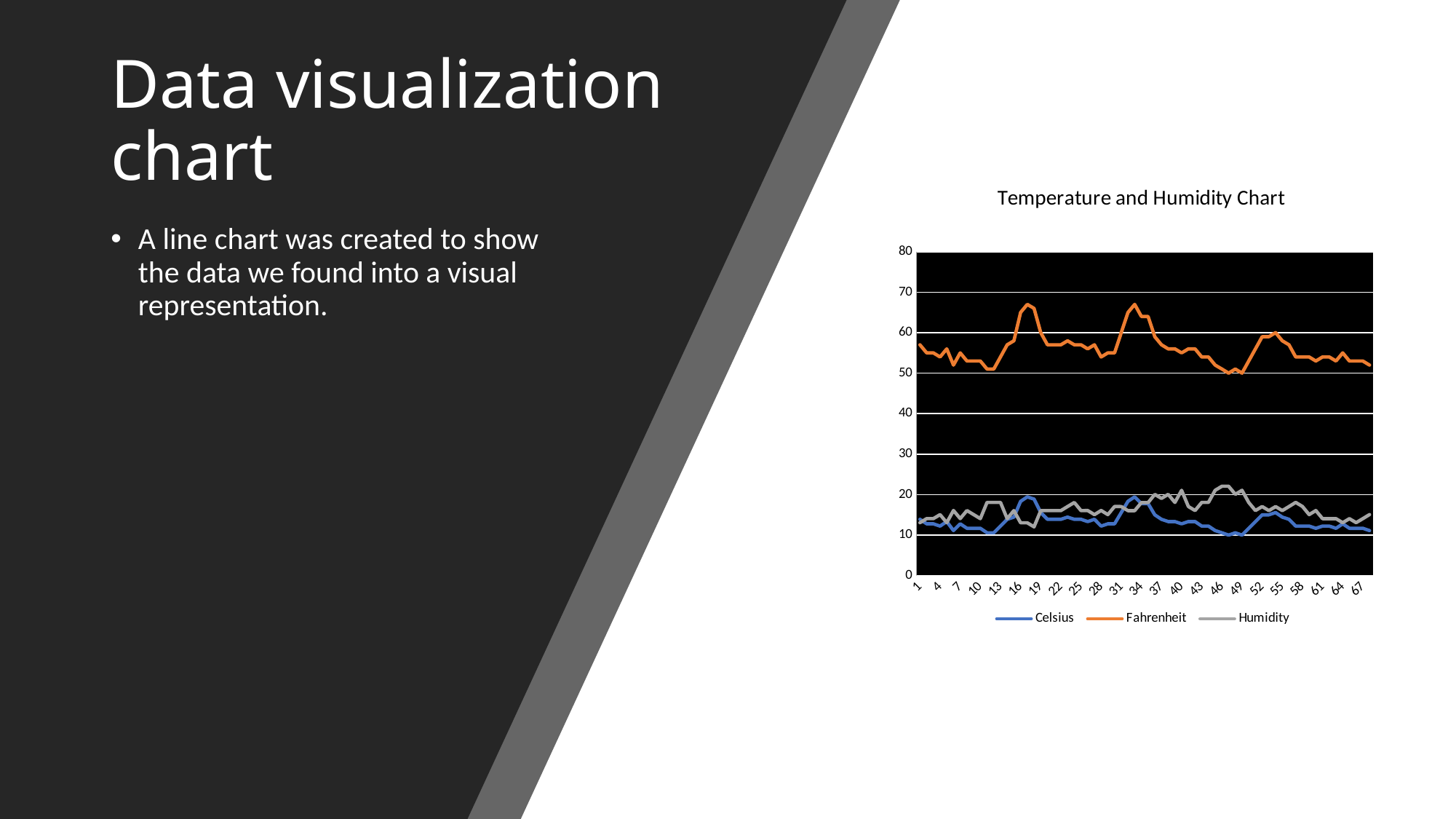
What is the highest value shown on the y axis of the chart? 80 Is the Fahrenheit value at point 1 greater or less than 50? greater What kind of chart is shown on the slide? line chart Which series is plotted in orange? Fahrenheit What is the title of the chart? Temperature and Humidity Chart Is the Celsius value at point 1 greater or less than 20? less Which is larger at point 46, the Humidity value or the Celsius value? Humidity Which series has the highest values throughout the chart? Fahrenheit Is the Humidity value at point 46 greater or less than 30? less Which is larger at point 34, the Fahrenheit value or the Celsius value? Fahrenheit How many series does the legend of the chart list? 3